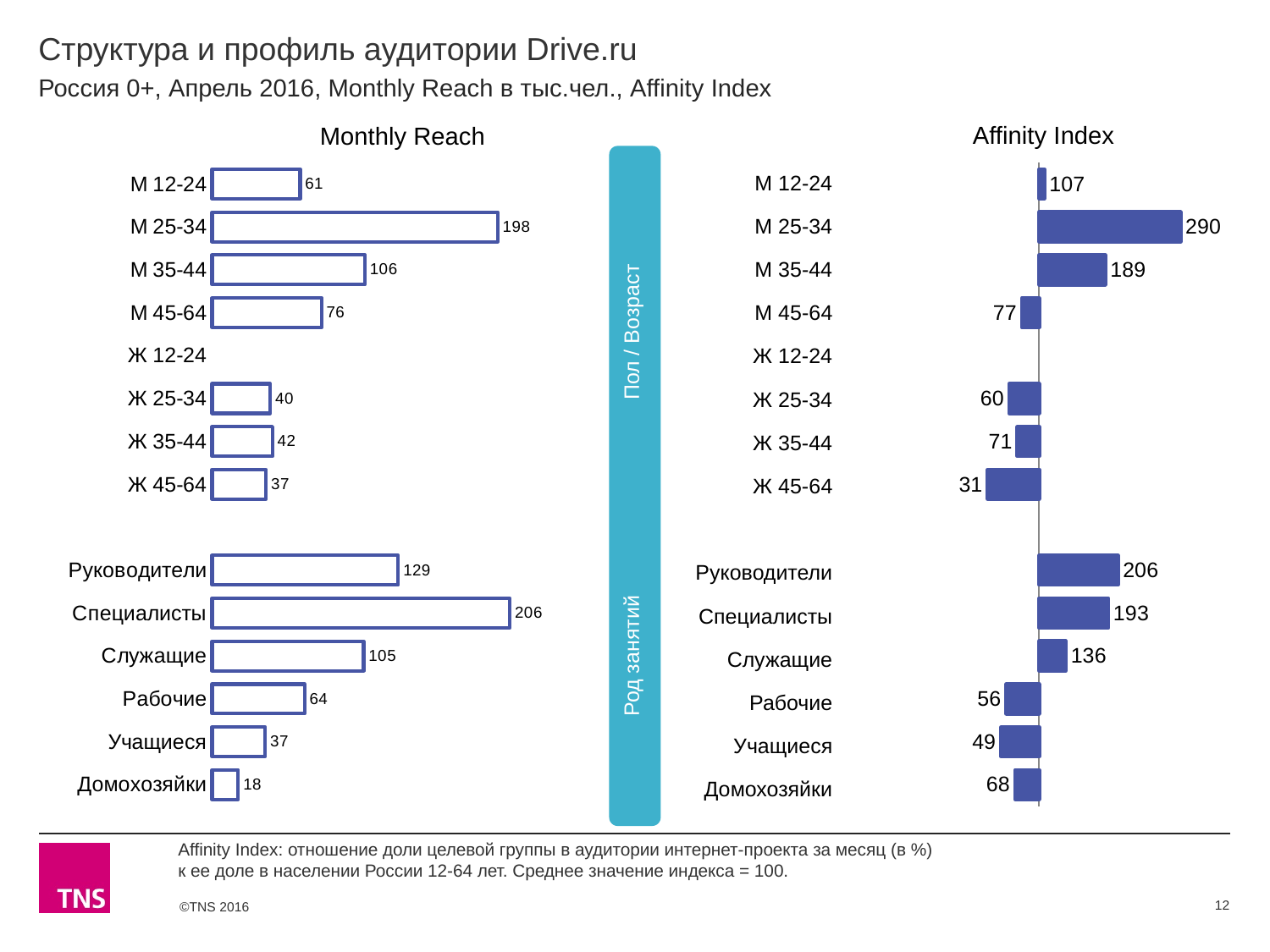
In the Monthly Reach chart, which is larger, the value for М 35-44 or the value for Служащие? М 35-44 In the Affinity Index chart, what is the difference between the values for М 25-34 and М 35-44? 101 In the Monthly Reach chart, what is the value for М 25-34? 198 In the Affinity Index chart, which is larger, the value for Рабочие or the value for Домохозяйки? Домохозяйки In the Monthly Reach chart, what is the difference between the values for Специалисты and Руководители? 77 In the Monthly Reach chart, what is the value for Домохозяйки? 18 In the Affinity Index chart, what is the value for Руководители? 206 In the Affinity Index chart, which category has the lowest value among those with a printed value? Ж 45-64 What type of chart is the Monthly Reach chart? Bar chart In the Affinity Index chart, what is the value for М 35-44? 189 In the Affinity Index chart, which category has the highest value? М 25-34 In the Monthly Reach chart, which category has the highest value? Специалисты